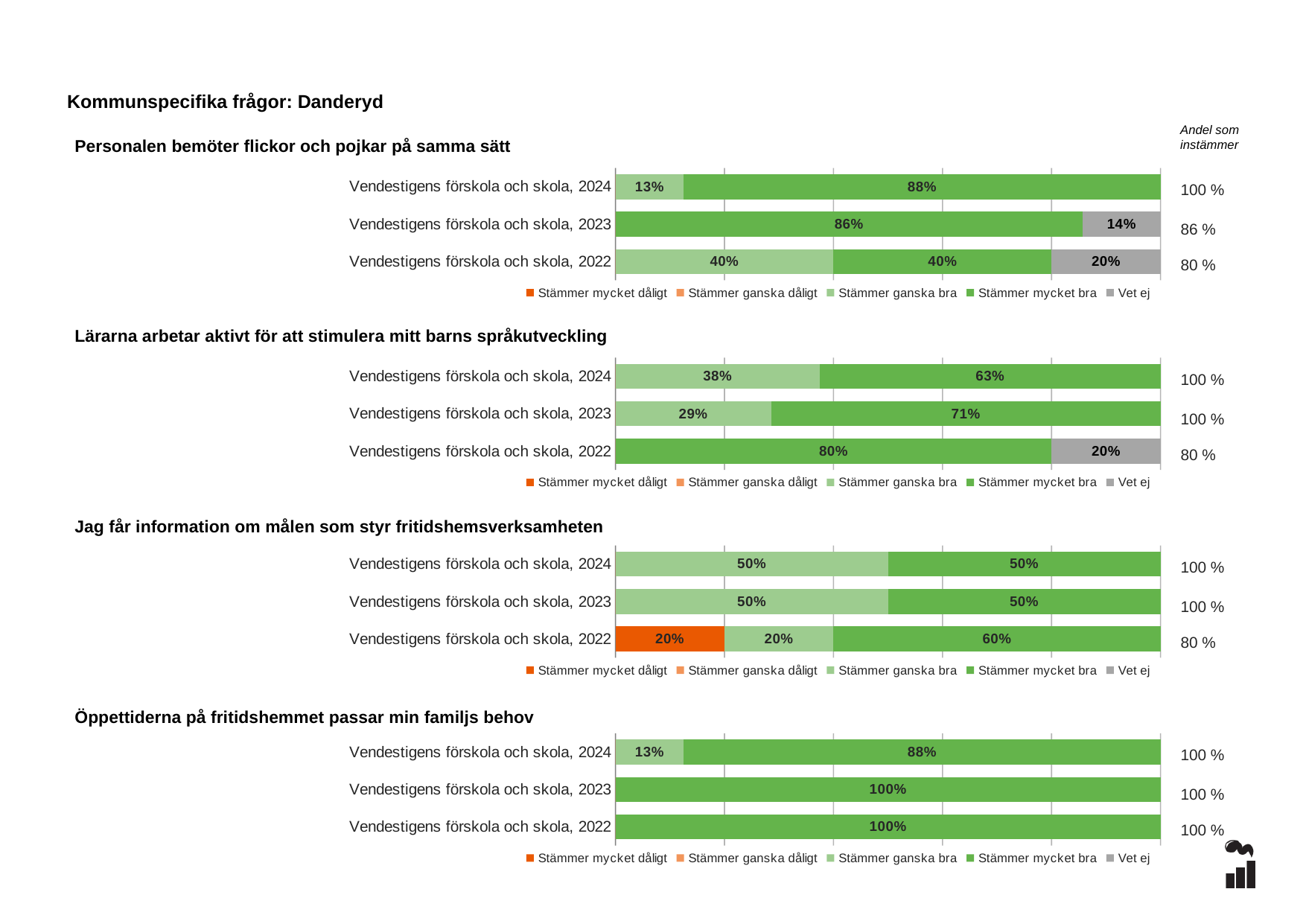
How many bars are shown in the chart 'Jag får information om målen som styr fritidshemsverksamheten'? 3 How many series does the legend list in the chart 'Personalen bemöter flickor och pojkar på samma sätt'? 5 In the chart 'Personalen bemöter flickor och pojkar på samma sätt', what is the 'Stämmer mycket bra' value for Vendestigens förskola och skola, 2023? 86% In the chart 'Jag får information om målen som styr fritidshemsverksamheten', what is the 'Stämmer mycket dåligt' value for Vendestigens förskola och skola, 2022? 20% In the chart 'Jag får information om målen som styr fritidshemsverksamheten', is the 'Stämmer mycket bra' value for 2022 larger or smaller than the 'Stämmer mycket bra' value for 2024? larger In the chart 'Personalen bemöter flickor och pojkar på samma sätt', what is the 'Vet ej' value for Vendestigens förskola och skola, 2022? 20% What type of chart is used for 'Öppettiderna på fritidshemmet passar min familjs behov'? Stacked bar chart In the chart 'Lärarna arbetar aktivt för att stimulera mitt barns språkutveckling', what is the 'Stämmer ganska bra' value for Vendestigens förskola och skola, 2024? 38% In the chart 'Lärarna arbetar aktivt för att stimulera mitt barns språkutveckling', what is the difference between the 'Stämmer mycket bra' values for 2023 and 2024? 8 percentage points In the chart 'Öppettiderna på fritidshemmet passar min familjs behov', which year has the lowest 'Stämmer mycket bra' value? Vendestigens förskola och skola, 2024 In the chart 'Lärarna arbetar aktivt för att stimulera mitt barns språkutveckling', which year has the highest 'Stämmer mycket bra' value? Vendestigens förskola och skola, 2022 In the chart 'Öppettiderna på fritidshemmet passar min familjs behov', what is the 'Stämmer mycket bra' value for Vendestigens förskola och skola, 2023? 100%